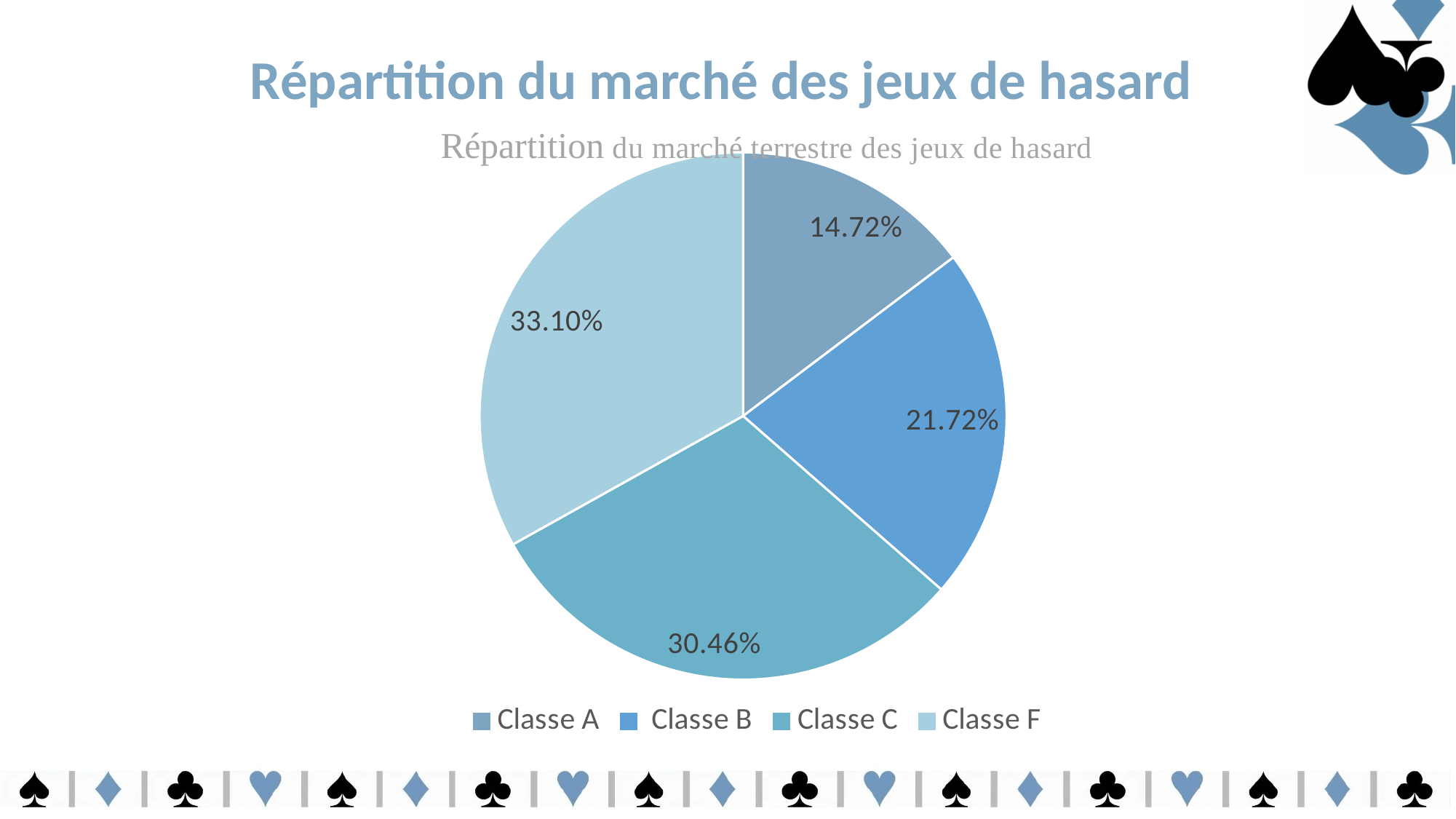
What is the difference between the shares of Classe C and Classe B? 8.74% How many slices does the pie chart have? 4 What is the share for Classe B? 21.72% Which class has the smallest share of the pie? Classe A What is the share for Classe A? 14.72% Which class has the largest share of the pie? Classe F What is the difference between the shares of Classe F and Classe A? 18.38% What is the share for Classe C? 30.46% Which is larger, the share of Classe B or the share of Classe C? Classe C What type of chart is shown on the slide? Pie chart What is the title of the chart? Répartition du marché terrestre des jeux de hasard What is the share for Classe F? 33.10%